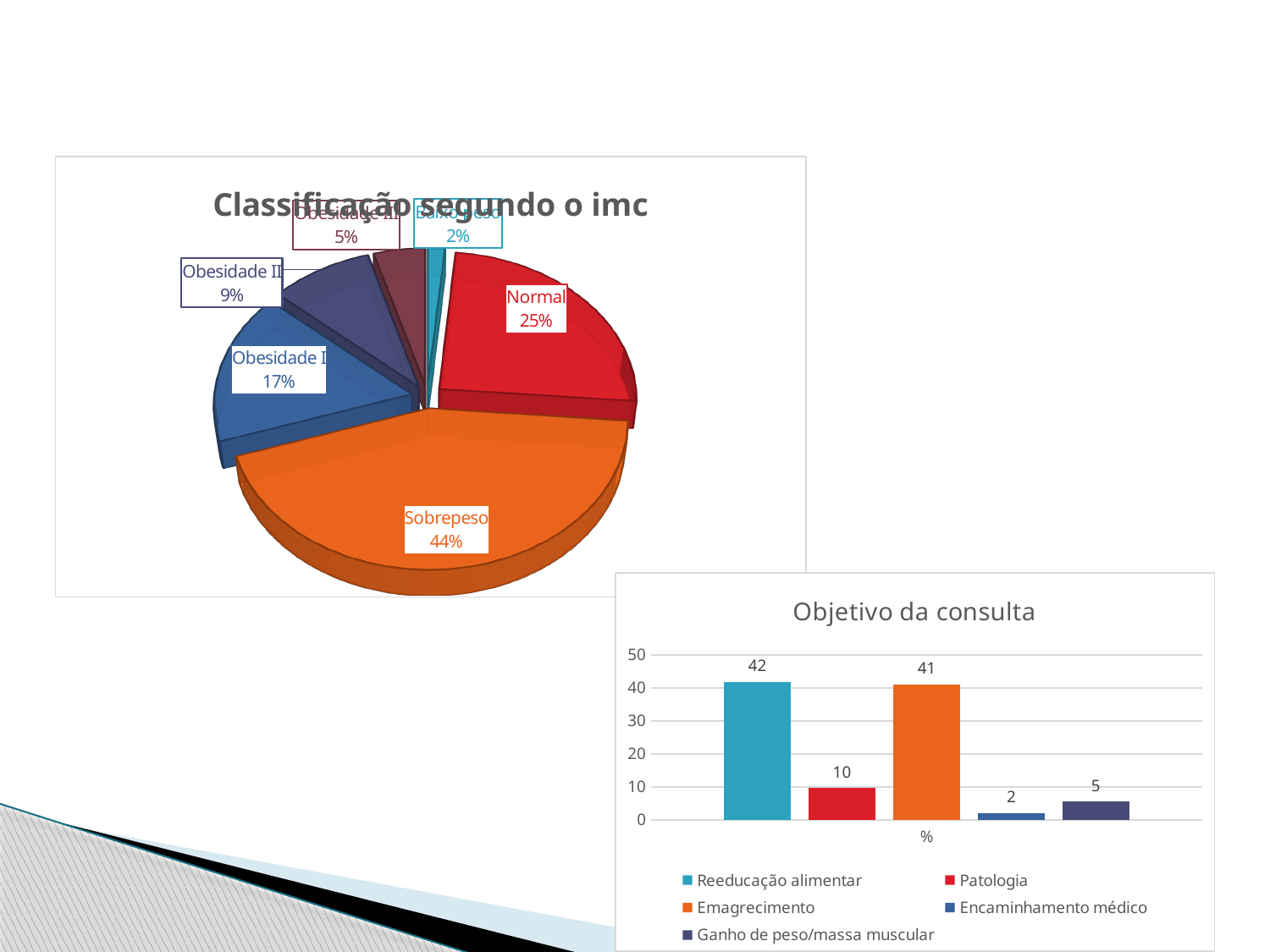
How many series does the legend of the 'Objetivo da consulta' chart list? 5 What kind of chart is 'Classificação segundo o imc'? Pie chart In the 'Objetivo da consulta' chart, which is larger, Emagrecimento or Ganho de peso/massa muscular? Emagrecimento In the 'Classificação segundo o imc' chart, what share does Sobrepeso have? 44% In the 'Classificação segundo o imc' chart, what percentage is shown for Normal? 25% In the 'Classificação segundo o imc' chart, what is the difference between Obesidade I and Obesidade II? 8% In the 'Classificação segundo o imc' chart, which category has the largest slice? Sobrepeso In the 'Objetivo da consulta' chart, what is the value for Patologia? 10 In the 'Objetivo da consulta' chart, which series has the highest value? Reeducação alimentar In the 'Objetivo da consulta' chart, what is the difference between Reeducação alimentar and Emagrecimento? 1 In the 'Classificação segundo o imc' chart, how many slices does the pie have? 6 In the 'Classificação segundo o imc' chart, which category has the smallest slice? Baixo peso